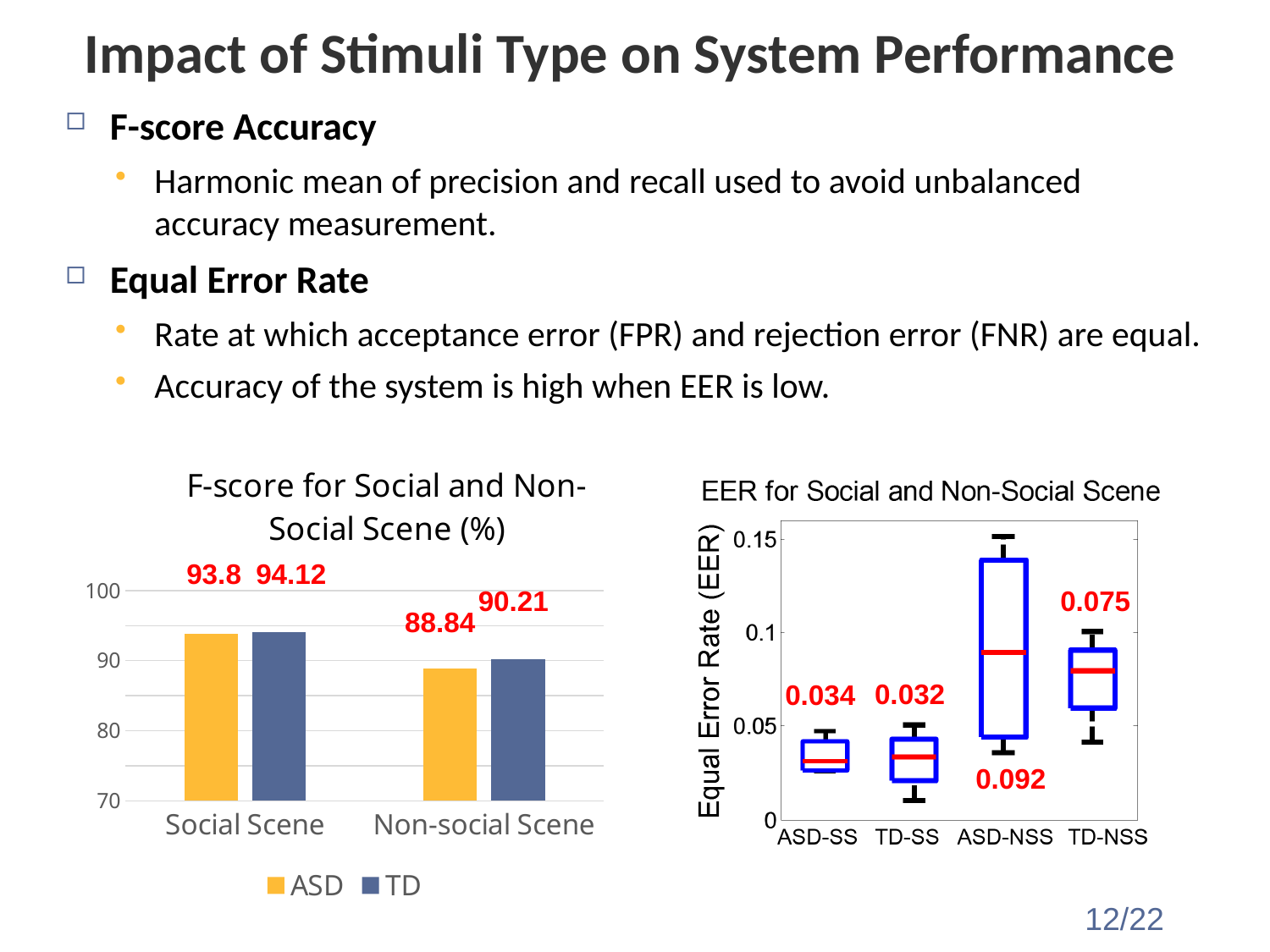
What kind of chart is the F-score for Social and Non-Social Scene chart? Bar chart In the F-score for Social and Non-Social Scene chart, what is the F-score for TD in the Non-social Scene? 90.21 In the F-score for Social and Non-Social Scene chart, what is the difference between the TD and ASD F-scores in the Non-social Scene? 1.37 In the F-score for Social and Non-Social Scene chart, which bar has the highest value? TD, Social Scene In the F-score for Social and Non-Social Scene chart, what is the F-score for ASD in the Social Scene? 93.8 In the F-score for Social and Non-Social Scene chart, how many series does the legend list? 2 In the F-score for Social and Non-Social Scene chart, what is the F-score for ASD in the Non-social Scene? 88.84 In the EER for Social and Non-Social Scene chart, which category has the highest labelled EER value? ASD-NSS In the EER for Social and Non-Social Scene chart, what is the labelled EER value for TD-SS? 0.032 In the EER for Social and Non-Social Scene chart, how many categories are shown on the x axis? 4 In the EER for Social and Non-Social Scene chart, what is the labelled EER value for ASD-NSS? 0.092 In the F-score for Social and Non-Social Scene chart, which bar has the lowest value? ASD, Non-social Scene